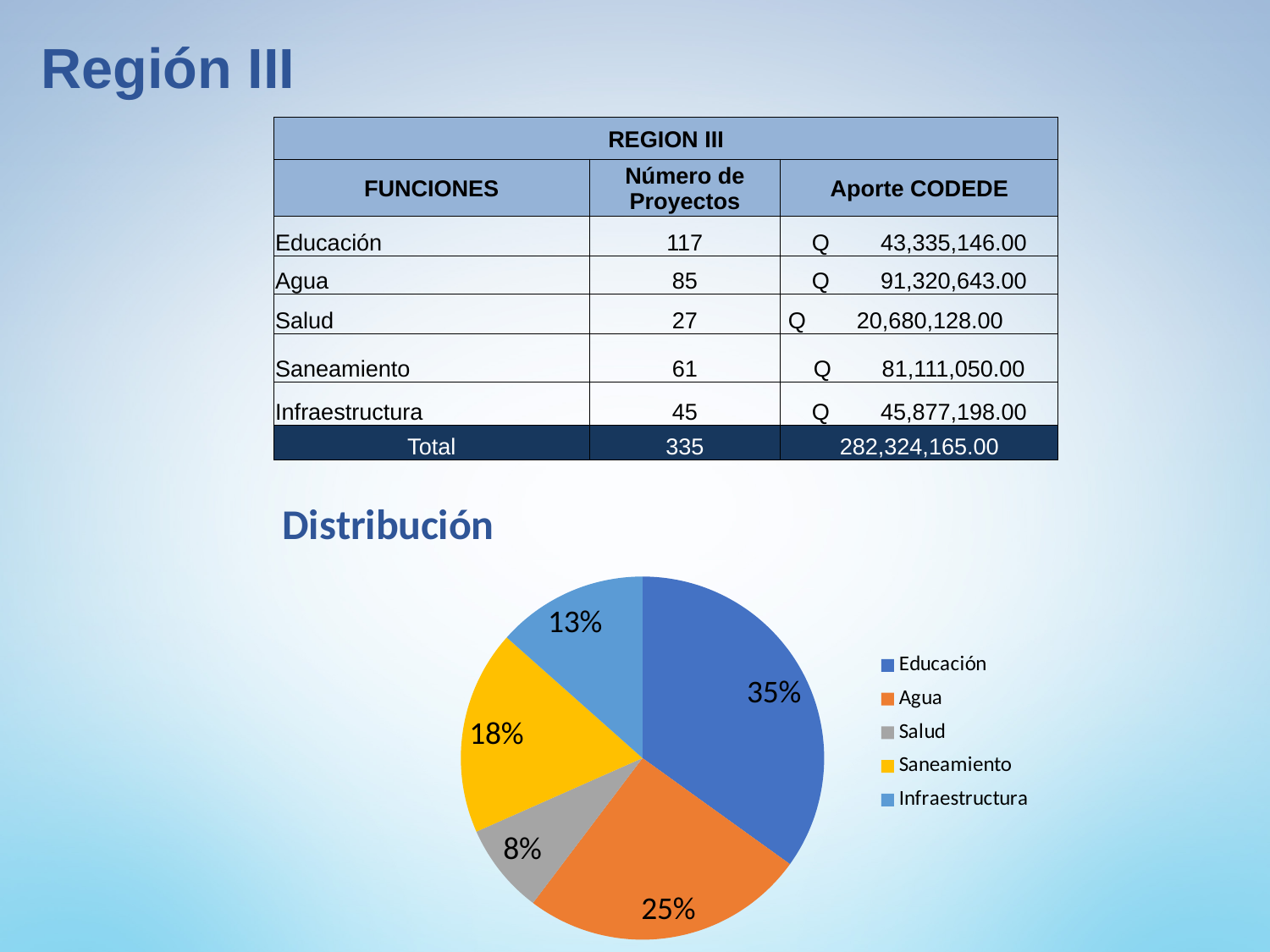
In the pie chart, which slice is larger, Saneamiento or Infraestructura? Saneamiento What colour is the Saneamiento slice in the pie chart? yellow In the pie chart, what share does Saneamiento have? 18% What is the difference in percentage points between the Educación and Agua slices in the pie chart? 10 Which category has the largest slice in the pie chart? Educación What kind of chart is shown under the heading "Distribución"? pie chart In the pie chart, what share does Educación have? 35% In the pie chart, what share does Agua have? 25% Which category has the smallest slice in the pie chart? Salud How many slices does the pie chart have? 5